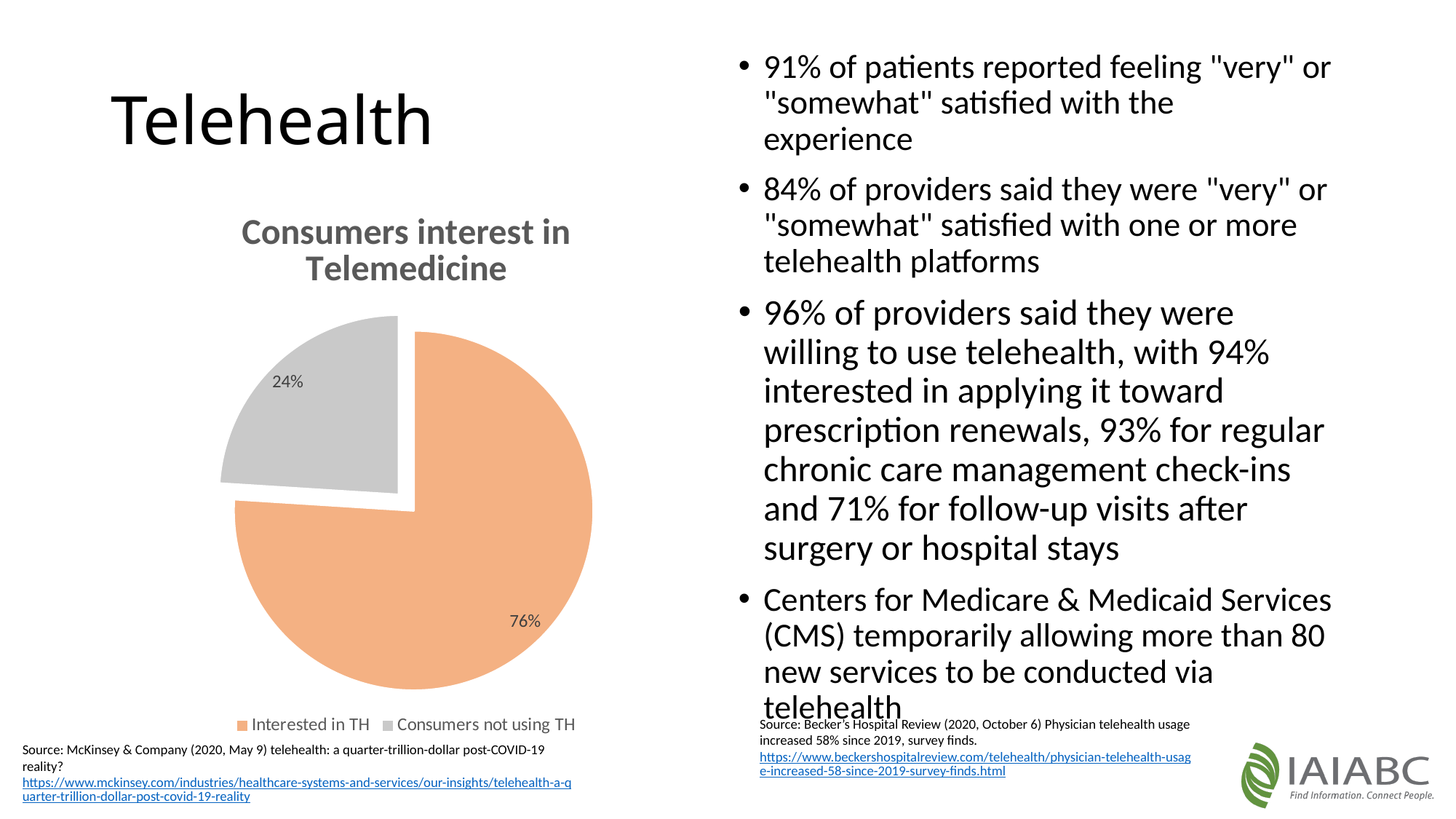
Which is larger: the "Interested in TH" slice or the "Consumers not using TH" slice? Interested in TH Which slice of the pie is the largest? Interested in TH What percentage of the pie is labelled "Interested in TH"? 76% What is the title of the chart? Consumers interest in Telemedicine What percentage of the pie is labelled "Consumers not using TH"? 24% How many slices does the pie chart have? 2 What share of the pie does the "Interested in TH" slice represent? 76% What colour is the "Consumers not using TH" slice? Grey What kind of chart is shown on the slide? Pie chart Which slice of the pie is the smallest? Consumers not using TH What is the difference in percentage points between the "Interested in TH" slice and the "Consumers not using TH" slice? 52 How many entries does the chart legend list? 2